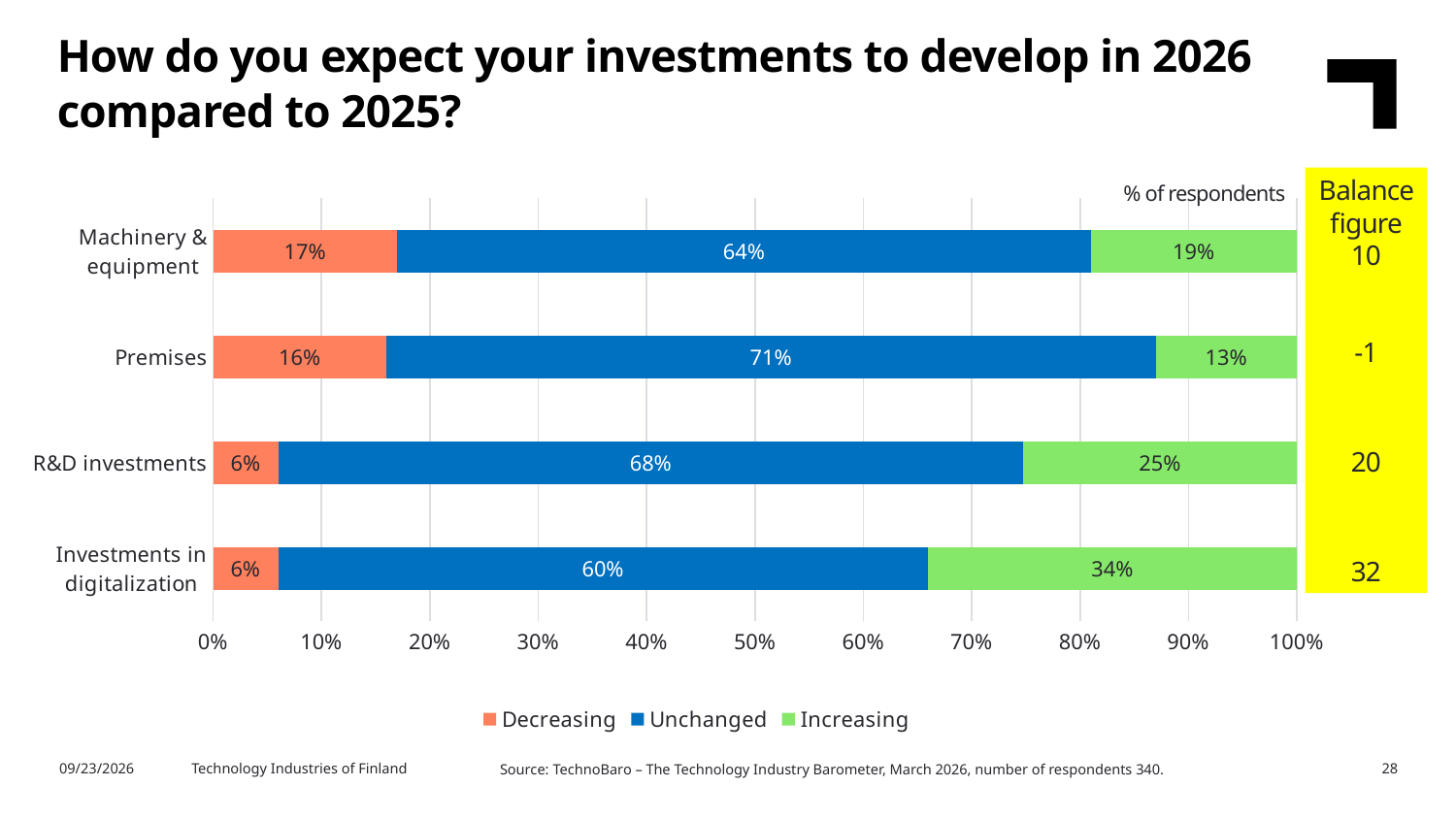
How many categories are shown on the chart? 4 What type of chart is shown on the slide? Stacked bar chart Which category has the highest Increasing share? Investments in digitalization What percentage of respondents expect Investments in digitalization to be Increasing? 34% How many series does the legend list? 3 Is the Decreasing share larger for Machinery & equipment or for R&D investments? Machinery & equipment What is the difference between the Increasing share for Investments in digitalization and for Premises? 21 percentage points What percentage of respondents expect R&D investments to be Increasing? 25% Which category has the lowest Increasing share? Premises What percentage of respondents expect Machinery & equipment investments to be Unchanged? 64% What percentage of respondents expect Premises investments to be Decreasing? 16% Which category has the highest Unchanged share? Premises